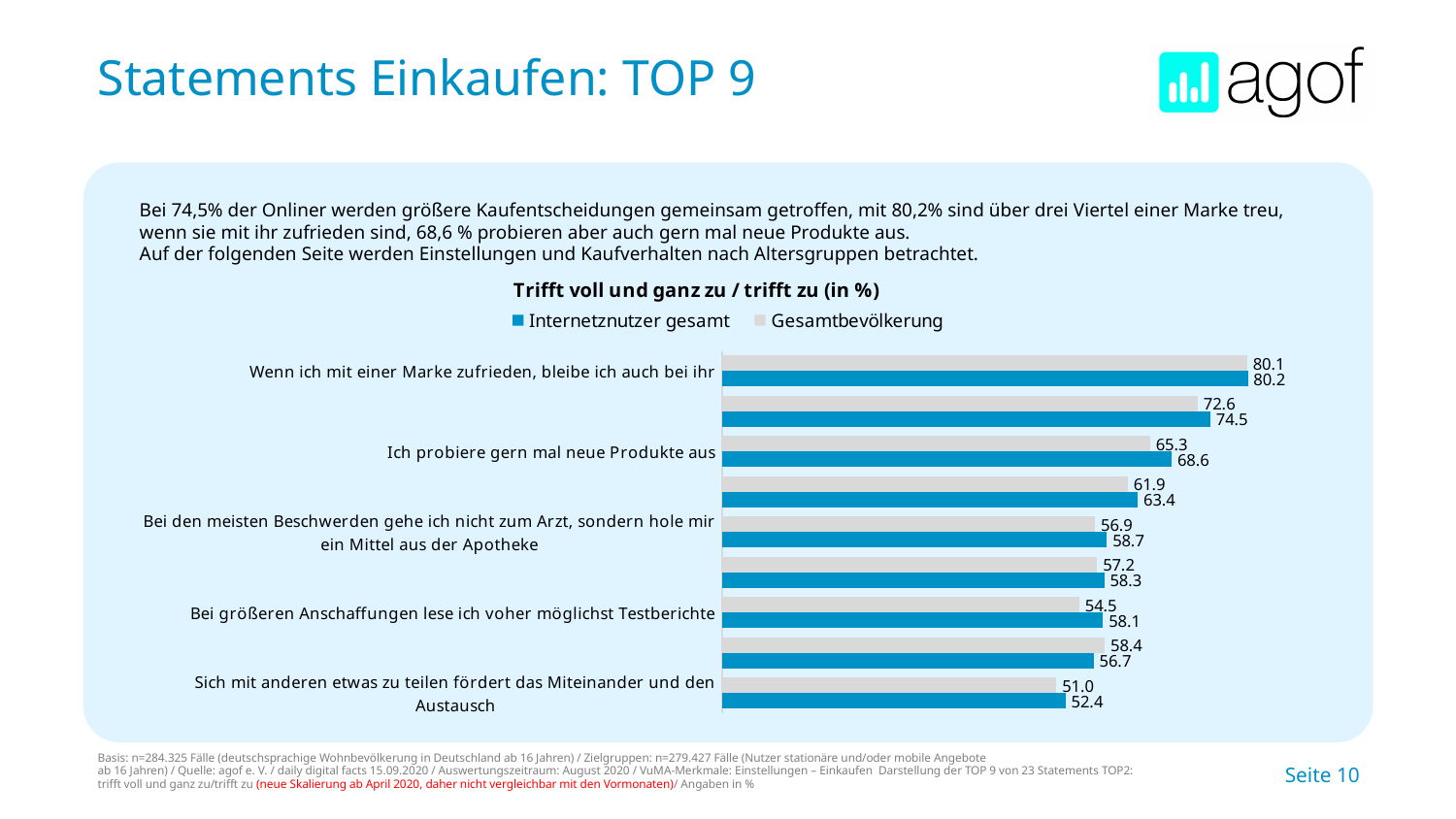
Which statement has the lowest value for Gesamtbevölkerung? Sich mit anderen etwas zu teilen fördert das Miteinander und den Austausch What is the title of the chart? Trifft voll und ganz zu / trifft zu (in %) What is the difference between Internetnutzer gesamt and Gesamtbevölkerung for "Ich probiere gern mal neue Produkte aus"? 3.3 What is the value for Gesamtbevölkerung for "Ich probiere gern mal neue Produkte aus"? 65.3 How many series does the chart legend list? 2 Which statement has the highest value for Internetnutzer gesamt? Wenn ich mit einer Marke zufrieden, bleibe ich auch bei ihr What kind of chart is shown on the slide? bar chart For "Bei den meisten Beschwerden gehe ich nicht zum Arzt, sondern hole mir ein Mittel aus der Apotheke", which series has the larger value, Internetnutzer gesamt or Gesamtbevölkerung? Internetnutzer gesamt What is the value for Internetnutzer gesamt for "Wenn ich mit einer Marke zufrieden, bleibe ich auch bei ihr"? 80.2 What is the value for Gesamtbevölkerung for "Sich mit anderen etwas zu teilen fördert das Miteinander und den Austausch"? 51.0 How many statements (categories) are plotted in the chart? 9 What is the value for Internetnutzer gesamt for "Bei größeren Anschaffungen lese ich voher möglichst Testberichte"? 58.1